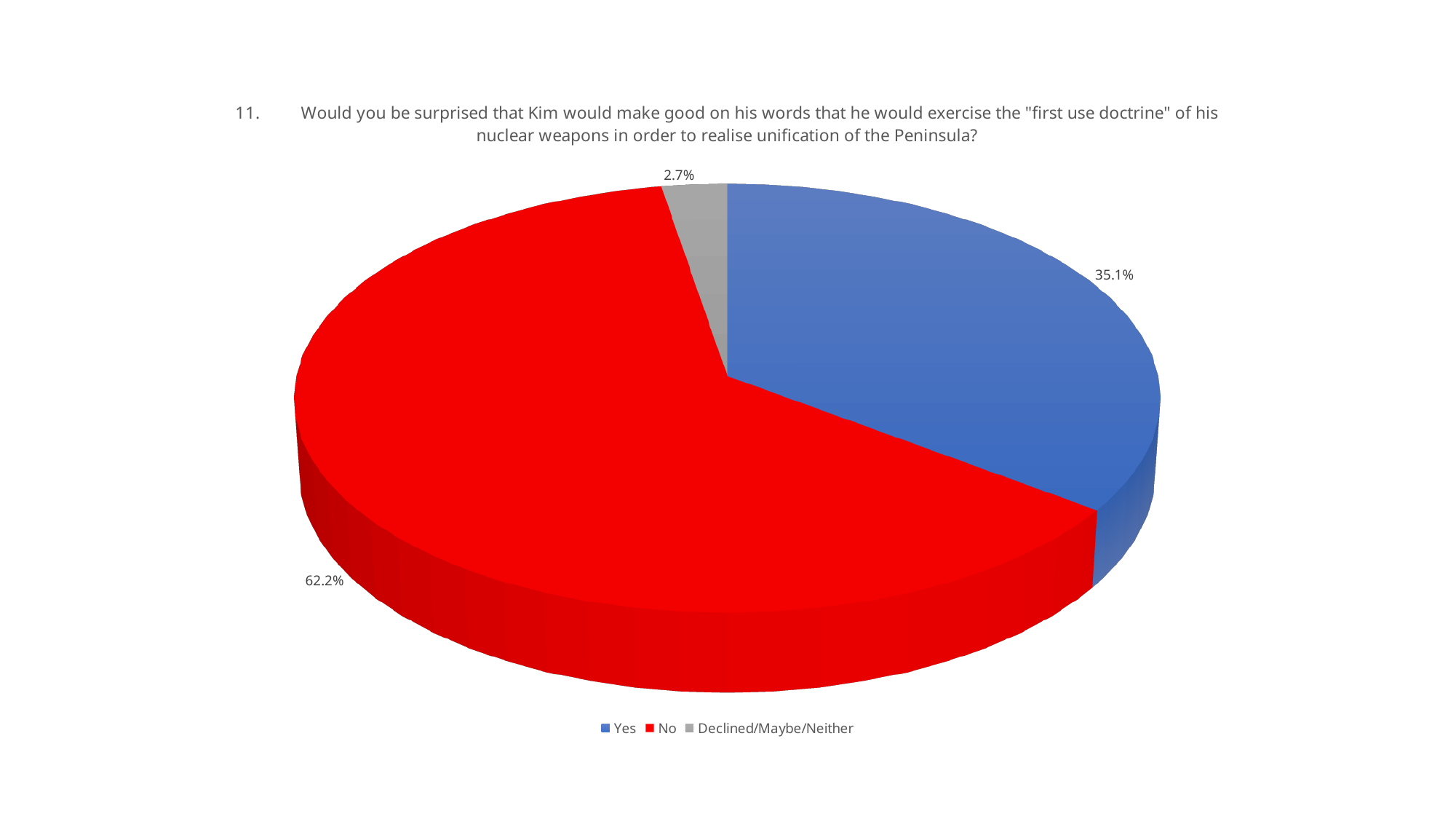
What percentage of respondents answered "No"? 62.2% How many slices does the pie chart have? 3 How many entries does the legend list? 3 Which response has the largest share of the pie? No What colour represents the "Yes" response in the chart? Blue What percentage of respondents fall under "Declined/Maybe/Neither"? 2.7% Which is larger, the "Yes" slice or the "No" slice? No What kind of chart is shown on the slide? Pie chart Which response has the smallest share of the pie? Declined/Maybe/Neither What colour represents the "No" response in the chart? Red What percentage of respondents answered "Yes"? 35.1% What is the difference in percentage points between the "No" and "Yes" slices? 27.1